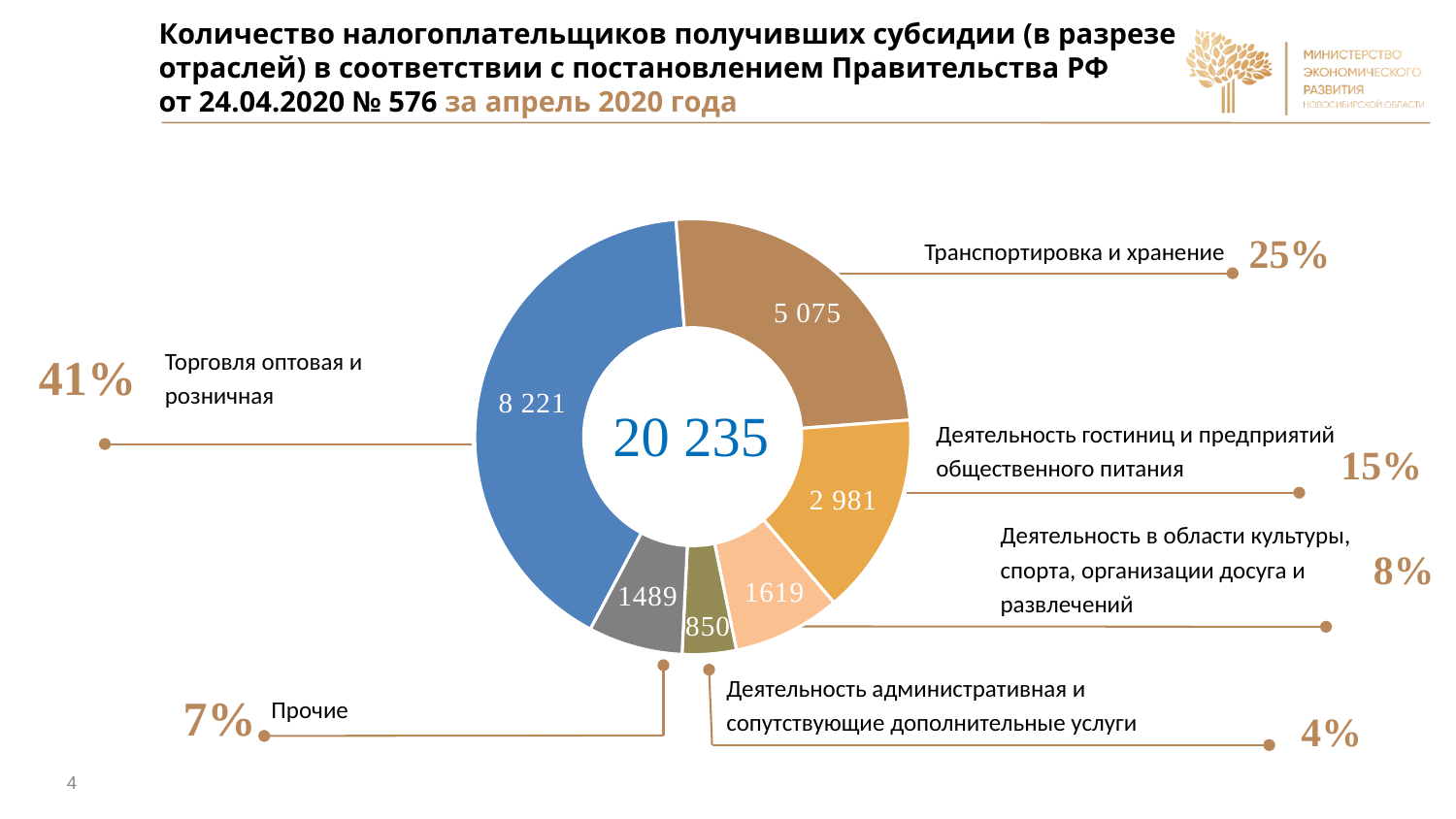
Which category has the highest value? Торговля оптовая и розничная What kind of chart is shown on the slide? doughnut (pie) chart What share of the chart does Деятельность в области культуры, спорта, организации досуга и развлечений represent? 8% What is the value for Торговля оптовая и розничная? 8 221 What is the difference between the values for Торговля оптовая и розничная and Транспортировка и хранение? 3 146 What total is shown in the centre of the chart? 20 235 What share of the chart does Прочие represent? 7% What is the value for Транспортировка и хранение? 5 075 Which category has the lowest value? Деятельность административная и сопутствующие дополнительные услуги What is the value for Деятельность административная и сопутствующие дополнительные услуги? 850 Which is larger: the value for Прочие or the value for Деятельность в области культуры, спорта, организации досуга и развлечений? Деятельность в области культуры, спорта, организации досуга и развлечений What is the value for Деятельность гостиниц и предприятий общественного питания? 2 981